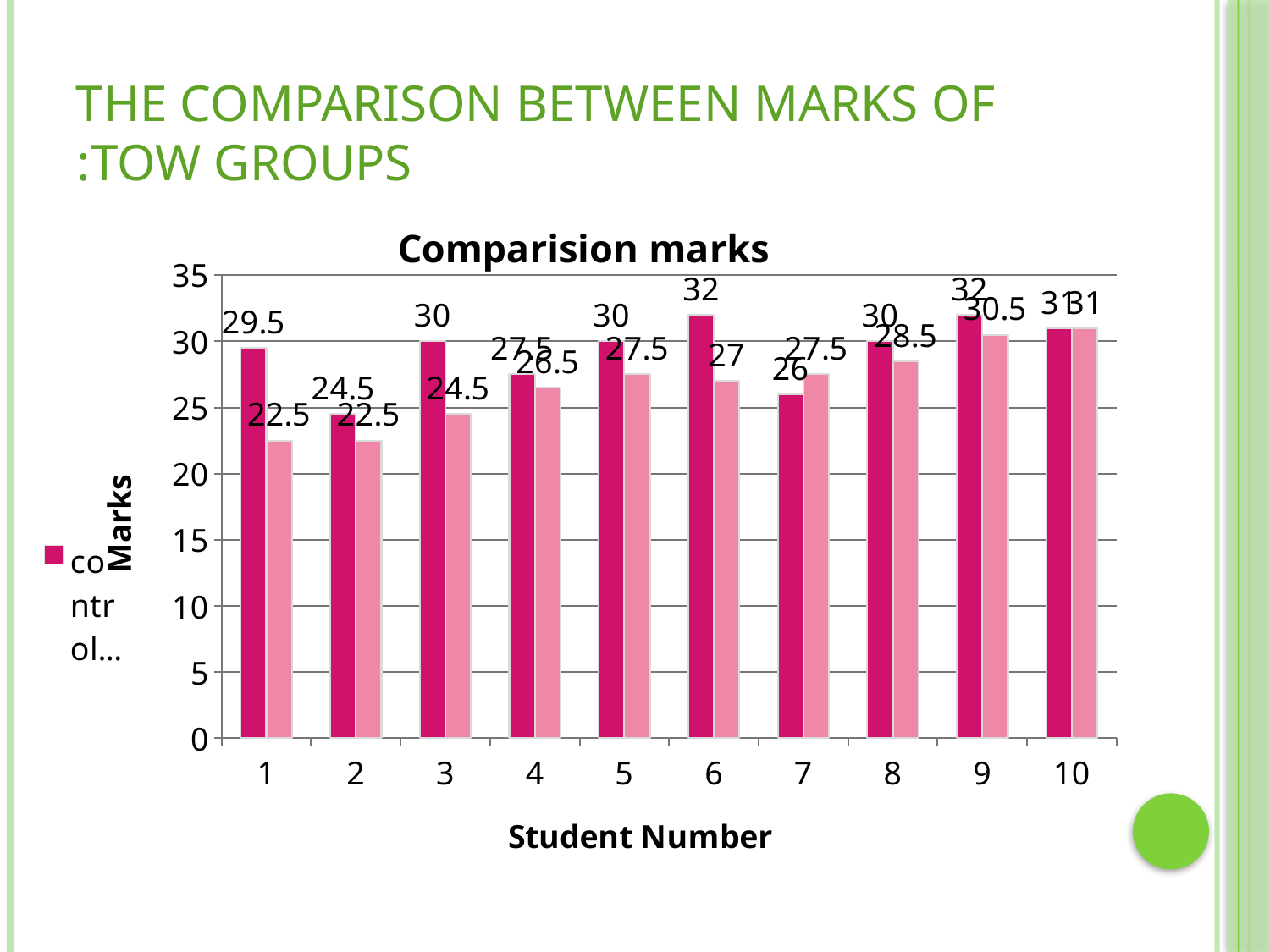
What is the value of the dark pink bar for student 1? 29.5 Which student number has the highest light pink bar? 10 What is the title of the chart? Comparision marks Is the value of the dark pink bar for student 6 greater or less than 30? greater What is the value of the light pink bar for student 8? 28.5 Do the light pink bars generally rise or fall from student 1 to student 10? rise What is the difference between the dark pink and light pink bars for student 1? 7 Which student number has the lowest dark pink bar? 2 What is the value of the dark pink bar for student 7? 26 How many student numbers are shown on the x axis? 10 For student 7, which bar is larger, the dark pink or the light pink? light pink What kind of chart is shown on the slide? bar chart